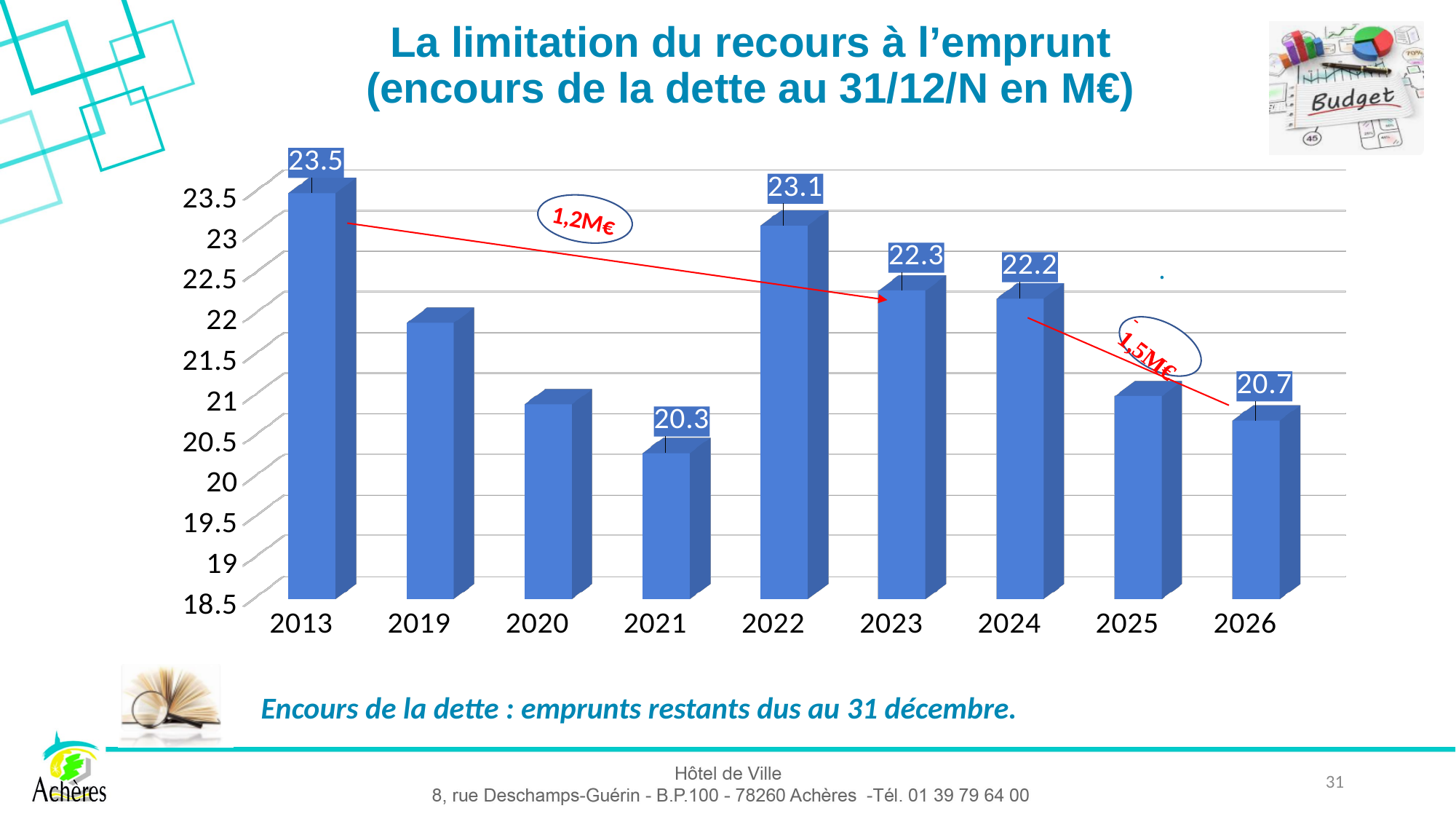
What is the difference between the values for 2013 and 2023? 1.2 Which is larger, the value for 2022 or the value for 2023? 2022 How many years are shown on the x axis? 9 What is the value for 2013? 23.5 Is the value for 2020 greater or less than 21.5? less Which year has the lowest value? 2021 What is the difference between the values for 2024 and 2026? 1.5 Which year has the highest value? 2013 What is the value for 2026? 20.7 What kind of chart is this? bar chart Is the value for 2019 greater or less than 21.5? greater What is the value for 2021? 20.3